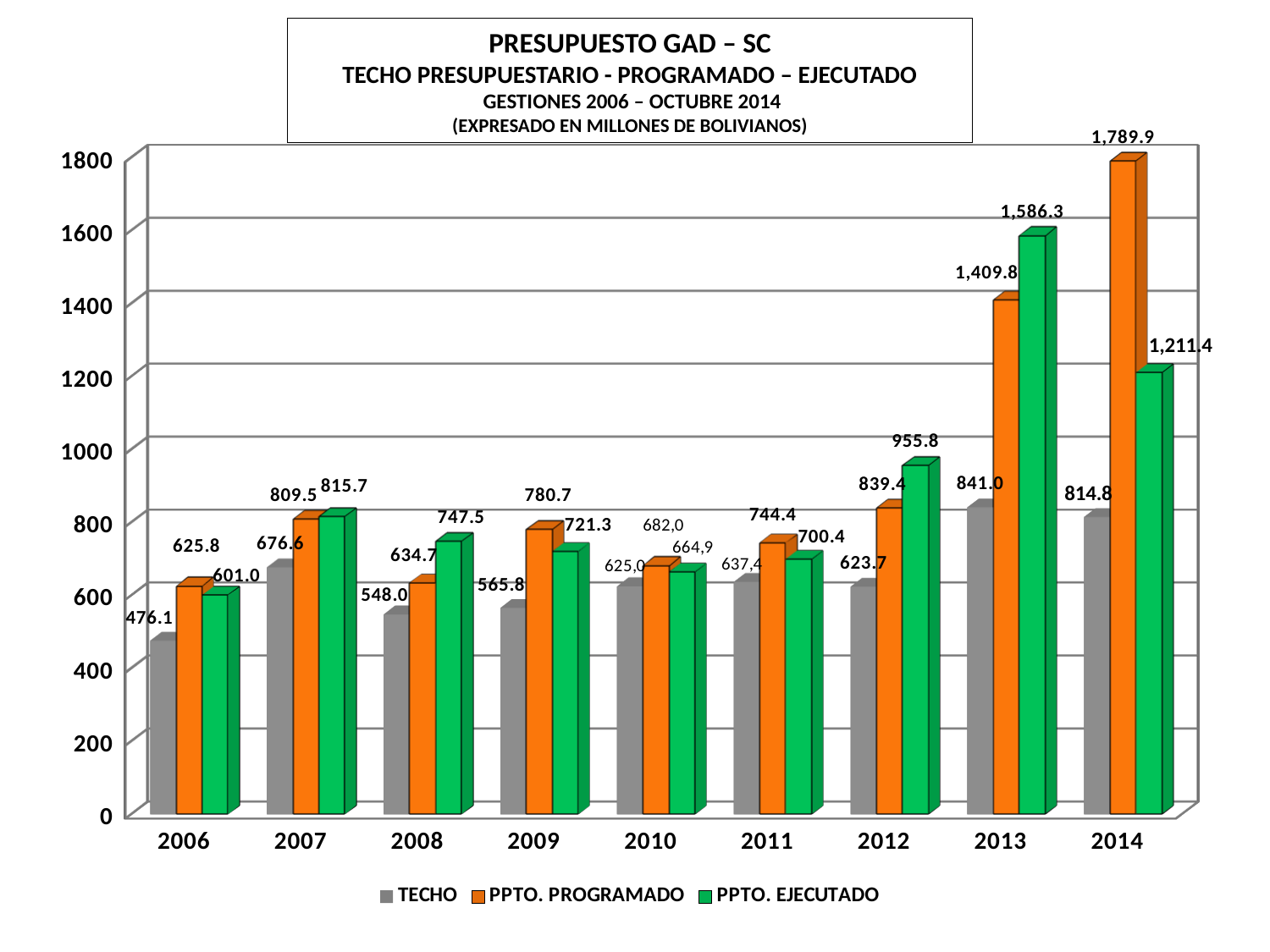
What is the difference between PPTO. EJECUTADO and PPTO. PROGRAMADO in 2013? 176.5 What is the PPTO. EJECUTADO value for 2012? 955.8 What kind of chart is shown on the slide? bar chart In which year is PPTO. EJECUTADO highest? 2013 In 2014, which is larger: PPTO. PROGRAMADO or PPTO. EJECUTADO? PPTO. PROGRAMADO What is the difference between PPTO. PROGRAMADO and TECHO in 2012? 215.7 What is the TECHO value for 2006? 476.1 How many series does the legend list? 3 How many years are shown on the x axis? 9 What is the value of PPTO. PROGRAMADO for 2014? 1,789.9 In which year is the TECHO value lowest? 2006 Is the TECHO value for 2013 greater or less than 800? greater